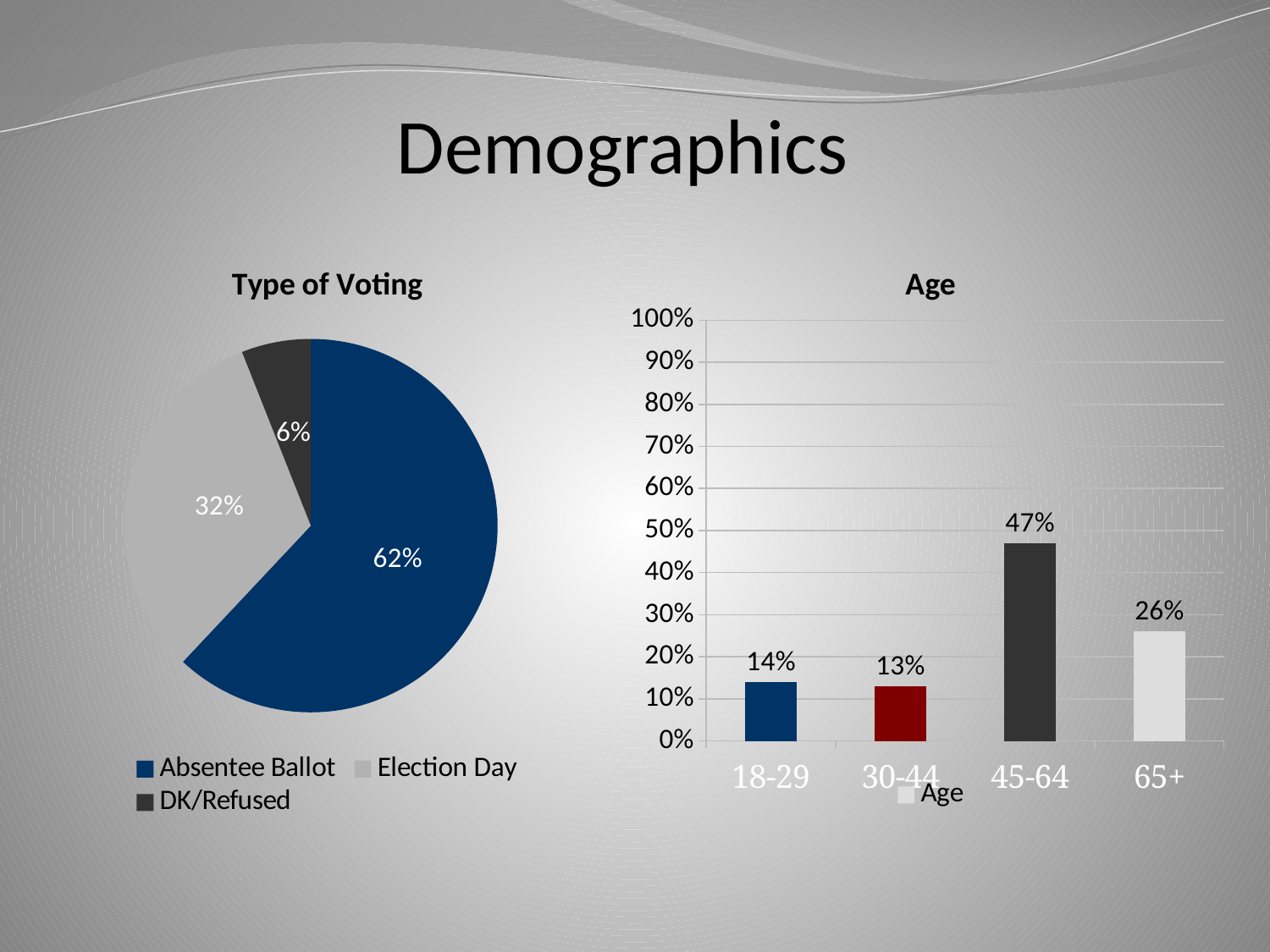
In the 'Age' chart, how many age categories are shown? 4 In the 'Age' chart, which age group has the lowest value? 30-44 In the 'Type of Voting' chart, what share of the pie is Absentee Ballot? 62% In the 'Type of Voting' chart, what kind of chart is shown? pie chart In the 'Age' chart, what is the difference between the values for 45-64 and 65+? 21% In the 'Age' chart, which age group has the highest value? 45-64 In the 'Type of Voting' chart, how many entries does the legend list? 3 In the 'Type of Voting' chart, which category has the smallest slice? DK/Refused In the 'Type of Voting' chart, what is the difference between the Absentee Ballot and Election Day shares? 30% In the 'Age' chart, what kind of chart is shown? bar chart In the 'Age' chart, what is the value for 45-64? 47% In the 'Type of Voting' chart, what percentage is shown for Election Day? 32%